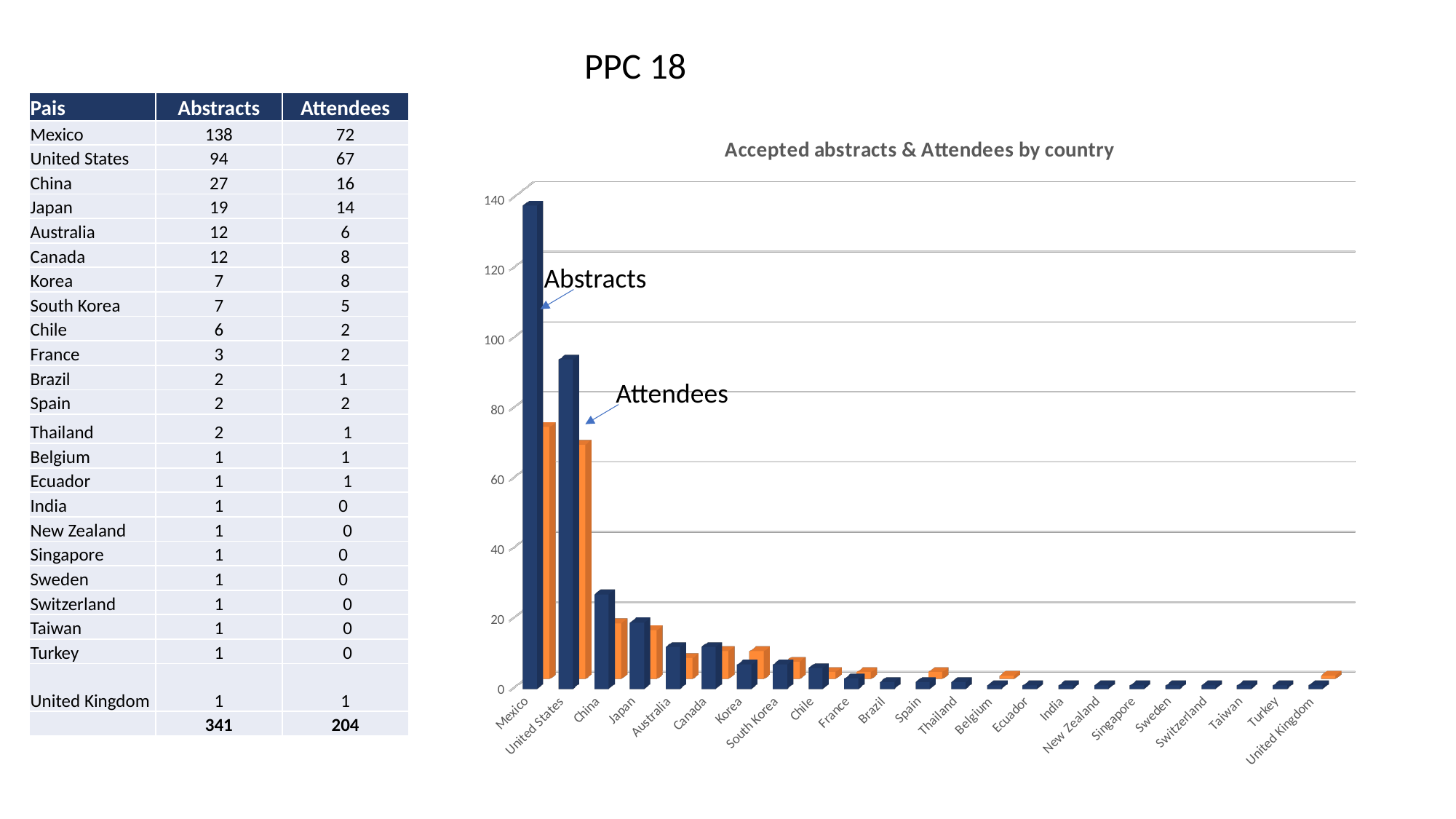
Is the Abstracts value for the United States greater or less than 80? greater How many countries are plotted along the x axis of the chart? 23 Which is larger for Korea, Abstracts or Attendees? Attendees Which country has the highest number of Abstracts? Mexico How many Abstracts does Mexico have? 138 What colour are the Attendees bars in the chart? orange What is the difference between Abstracts and Attendees for Mexico? 66 What kind of chart is shown on the slide? bar chart Do the Abstracts values rise or fall moving from left to right along the x axis? fall How many Attendees does the United States have? 67 What is the title of the chart? Accepted abstracts & Attendees by country How many data series does the chart show? 2